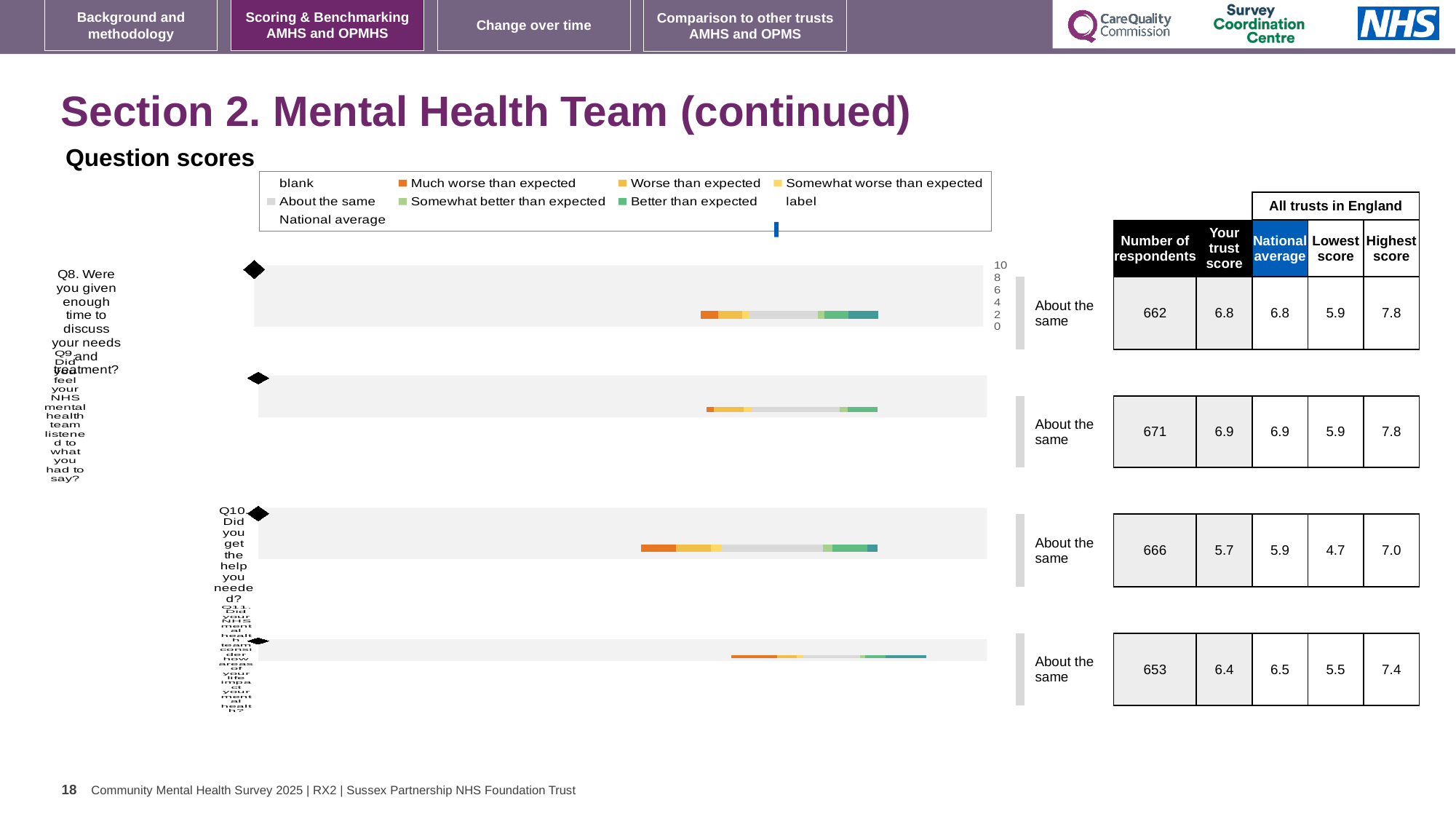
What rating label is shown next to each of the four question charts? About the same Which colour in the legend represents 'Much worse than expected'? orange How many question charts (Q8 to Q11) are shown on the slide? 4 For Q10, what is the difference between the highest score (7.0) and the lowest score (4.7) among all trusts in England? 2.3 For Q10 (Did you get the help you needed?), what is the national average score? 5.9 For Q9 (Did you feel your NHS mental health team listened to what you had to say?), what is the number of respondents? 671 For Q8 (Were you given enough time to discuss your needs and treatment?), what is your trust score? 6.8 For Q11, what is the highest score among all trusts in England? 7.4 For Q11, is your trust score higher or lower than the national average? lower Which question has the lowest 'Your trust score'? Q10 Which question has the highest number of respondents? Q9 What kind of chart is used to show the question scores for Q8 to Q11? bar chart